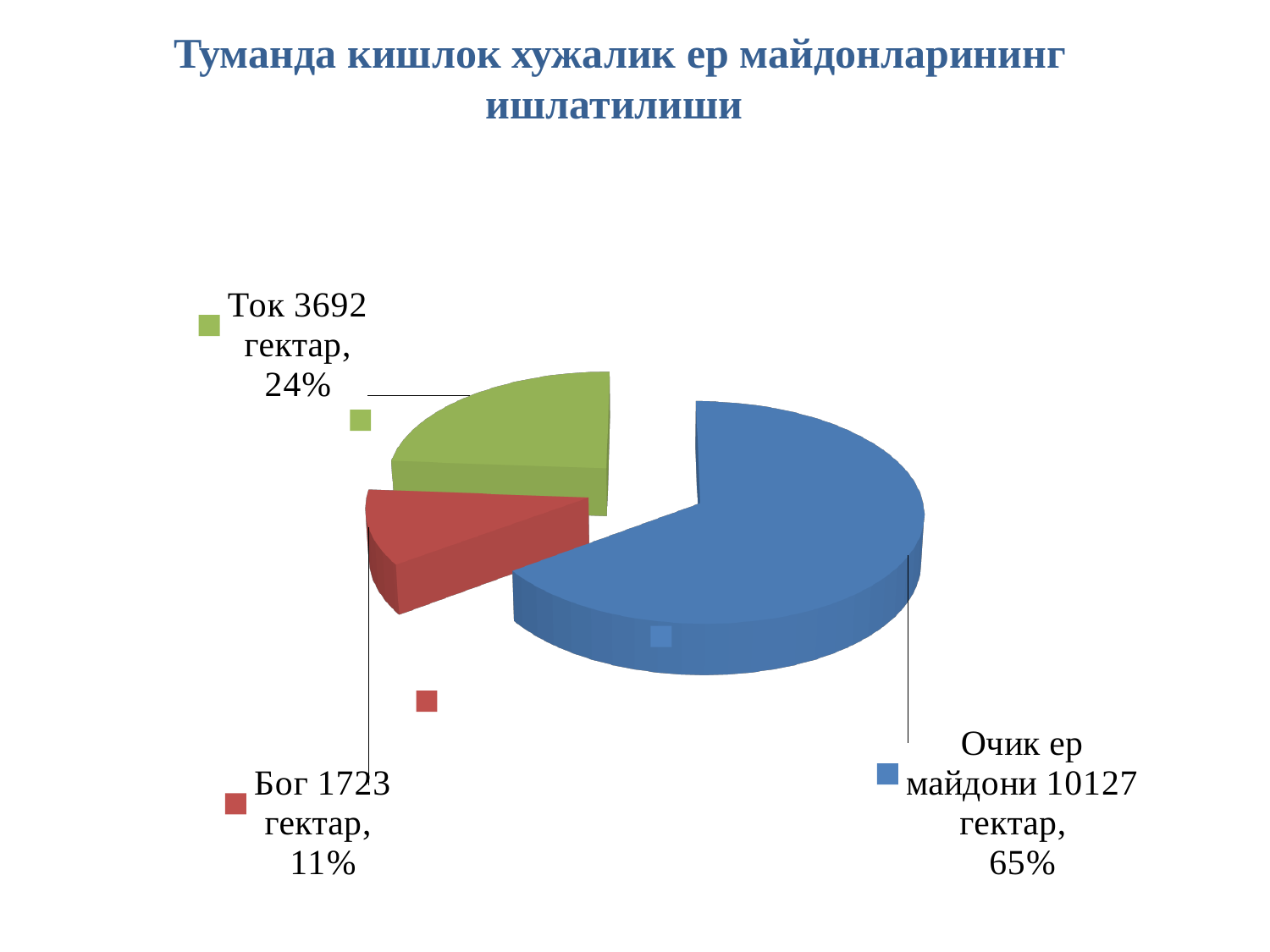
How many slices does the pie chart have? 3 Which category has the largest slice of the pie? Очик ер майдони What is the area in hectares for Очик ер майдони? 10127 гектар What is the area in hectares for Ток? 3692 гектар What is the difference in hectares between Очик ер майдони and Ток? 6435 Which category has the smallest slice of the pie? Бог What share of the pie does Ток represent? 24% Which is larger, the area for Ток or the area for Бог? Ток What share of the pie does Очик ер майдони represent? 65% What share of the pie does Бог represent? 11% What is the area in hectares for Бог? 1723 гектар What kind of chart is shown on the slide? pie chart